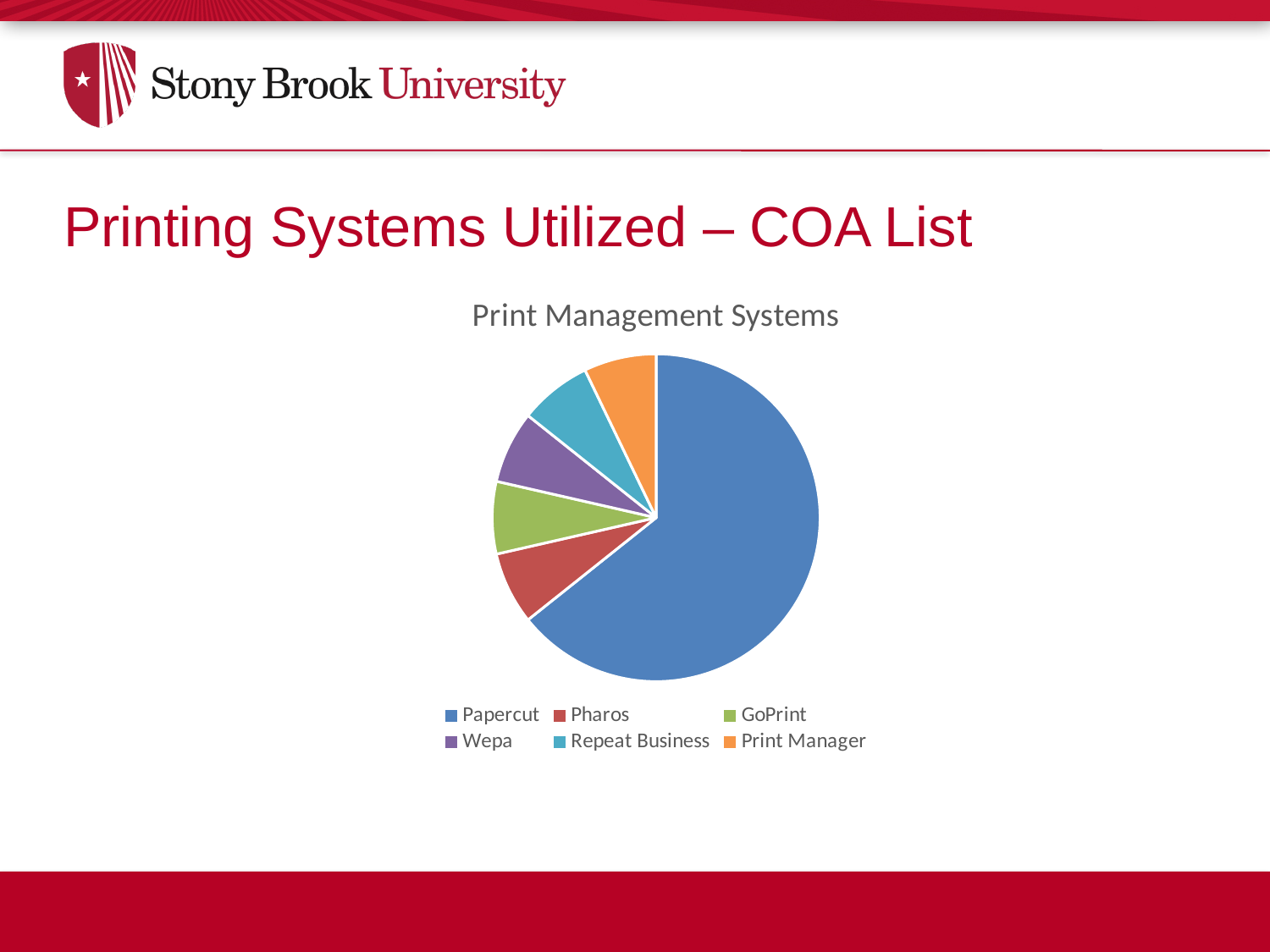
Which slice is larger, Wepa or Papercut? Papercut Which slice is larger, Papercut or Pharos? Papercut Does Papercut account for more or less than half of the pie? More Which category is shown in blue in the pie chart? Papercut What kind of chart is shown on the slide? Pie chart Which print management system has the largest slice of the pie? Papercut What is the title of the chart? Print Management Systems How many slices does the pie chart have? 6